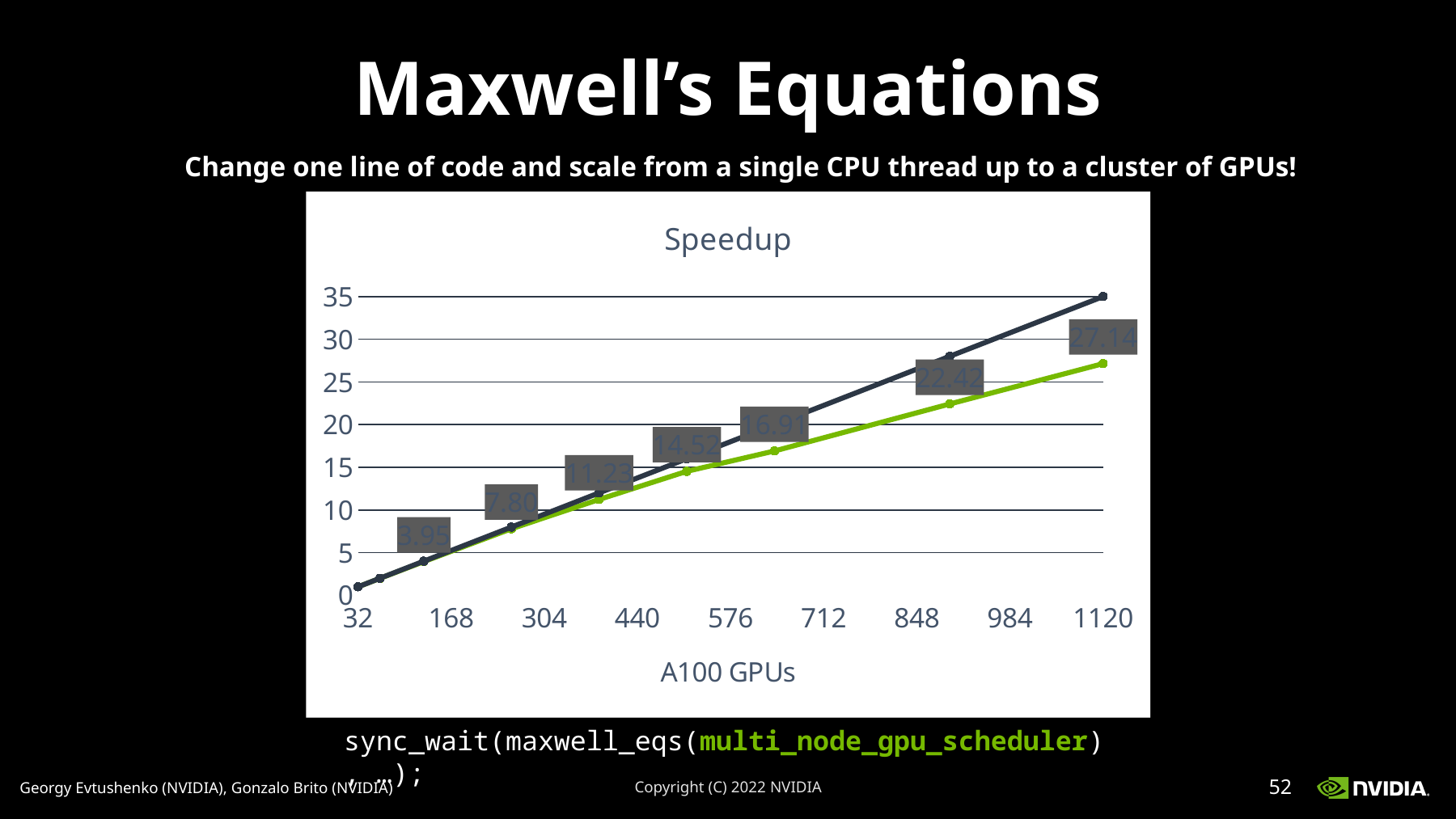
Is the value of the green line at 1120 A100 GPUs greater or less than 30? less At 1120 A100 GPUs, which line is higher: the dark line or the green line? the dark line Is the value of the dark line at 1120 A100 GPUs greater or less than 30? greater Does the speedup on the green line rise or fall as the number of A100 GPUs increases? rise What is the difference between the two highest data labels on the green line, 27.14 and 22.42? 4.72 What is the lowest data label shown on the green line? 3.95 What is the highest data label shown on the green line? 27.14 How many data labels are printed on the green line? 7 What type of chart is shown on the slide? line chart What is the speedup value labelled on the green line at 1120 A100 GPUs? 27.14 What is the x-axis title of the chart? A100 GPUs What is the title of the chart? Speedup